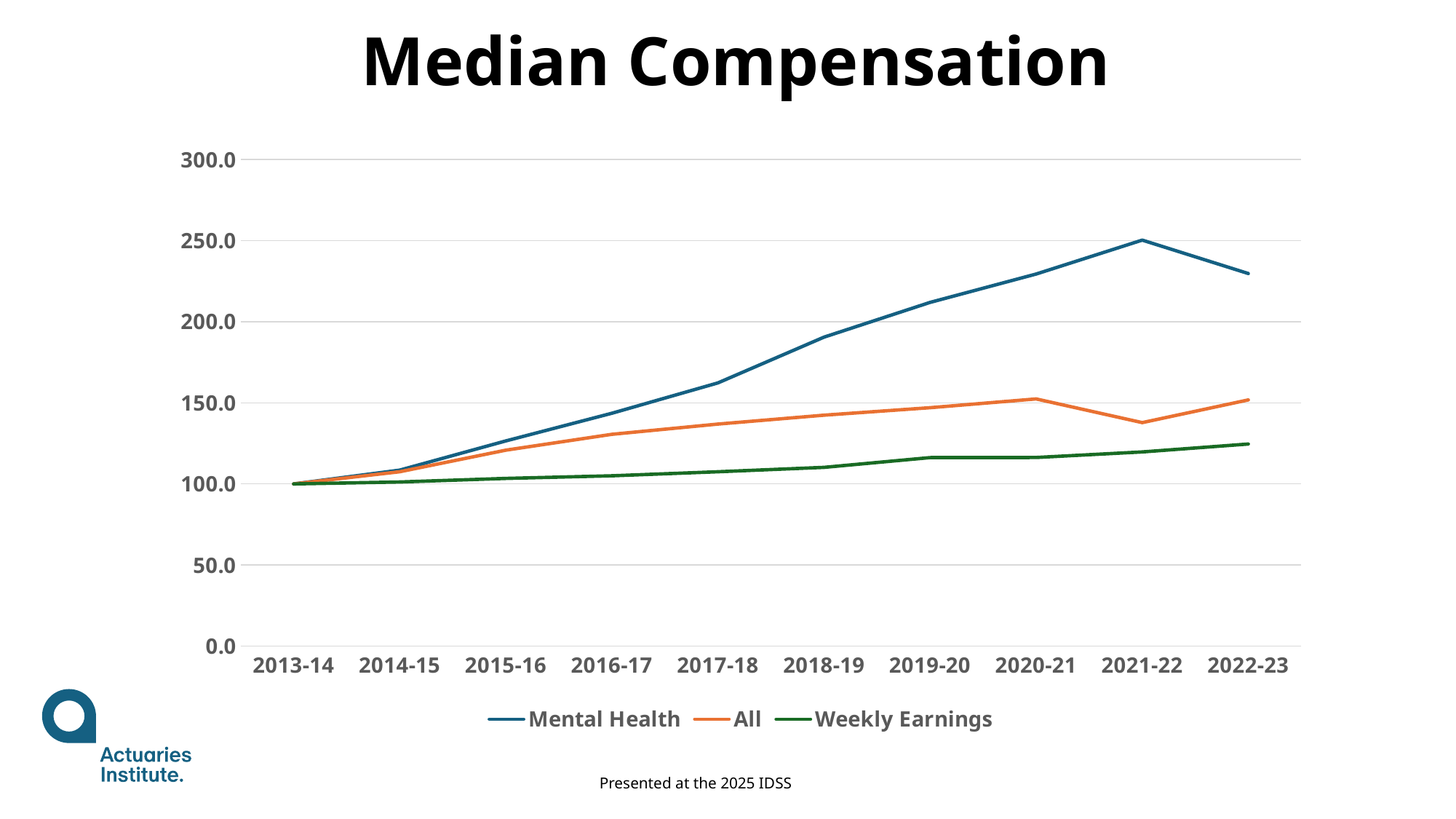
Which series is shown in green in the legend? Weekly Earnings Which series has the lowest value in 2020-21? Weekly Earnings Is the value for All in 2021-22 greater or less than 150.0? less In which period does the Mental Health series reach its highest value? 2021-22 Which series has the highest value in 2022-23? Mental Health Which is larger in 2018-19, the value for Mental Health or the value for All? Mental Health Is the value for Weekly Earnings in 2022-23 greater or less than 150.0? less Is the value for Mental Health in 2019-20 greater or less than 200.0? greater What kind of chart is shown on the slide? line chart How many series does the legend list? 3 How many time periods are shown on the x axis? 10 What is the title of the chart? Median Compensation